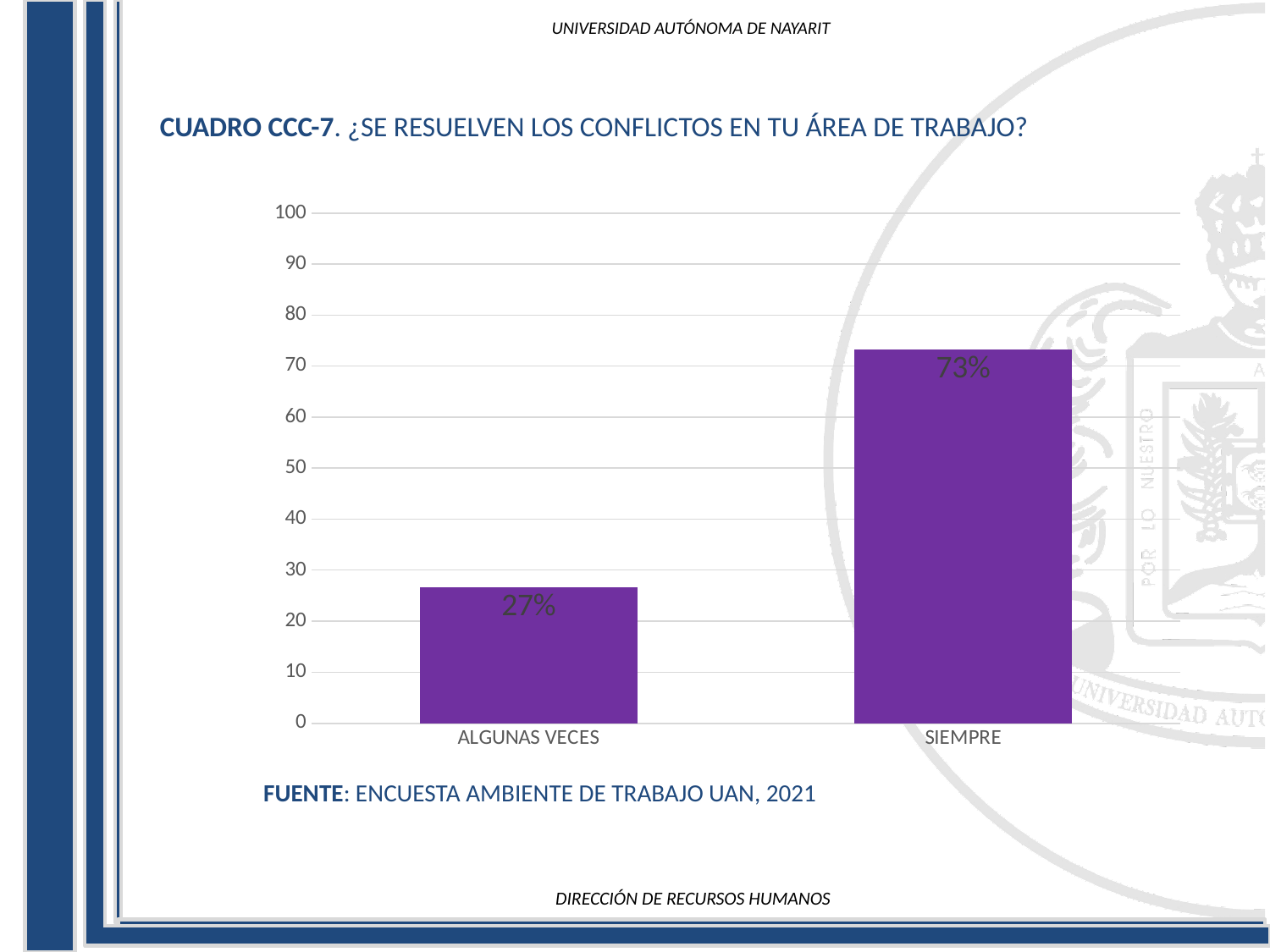
Which category has the lowest value? ALGUNAS VECES What is the difference between the values for SIEMPRE and ALGUNAS VECES? 46% What is the value for SIEMPRE? 73% What is the value for ALGUNAS VECES? 27% Is the value for ALGUNAS VECES greater or less than 30? less What kind of chart is shown on the slide? bar chart How many categories are shown on the x axis? 2 Is the value for SIEMPRE greater or less than 50? greater Which is larger, the value for ALGUNAS VECES or the value for SIEMPRE? SIEMPRE What source is cited below the chart? ENCUESTA AMBIENTE DE TRABAJO UAN, 2021 What is the title of the chart? CUADRO CCC-7. ¿SE RESUELVEN LOS CONFLICTOS EN TU ÁREA DE TRABAJO? Which category has the highest value? SIEMPRE